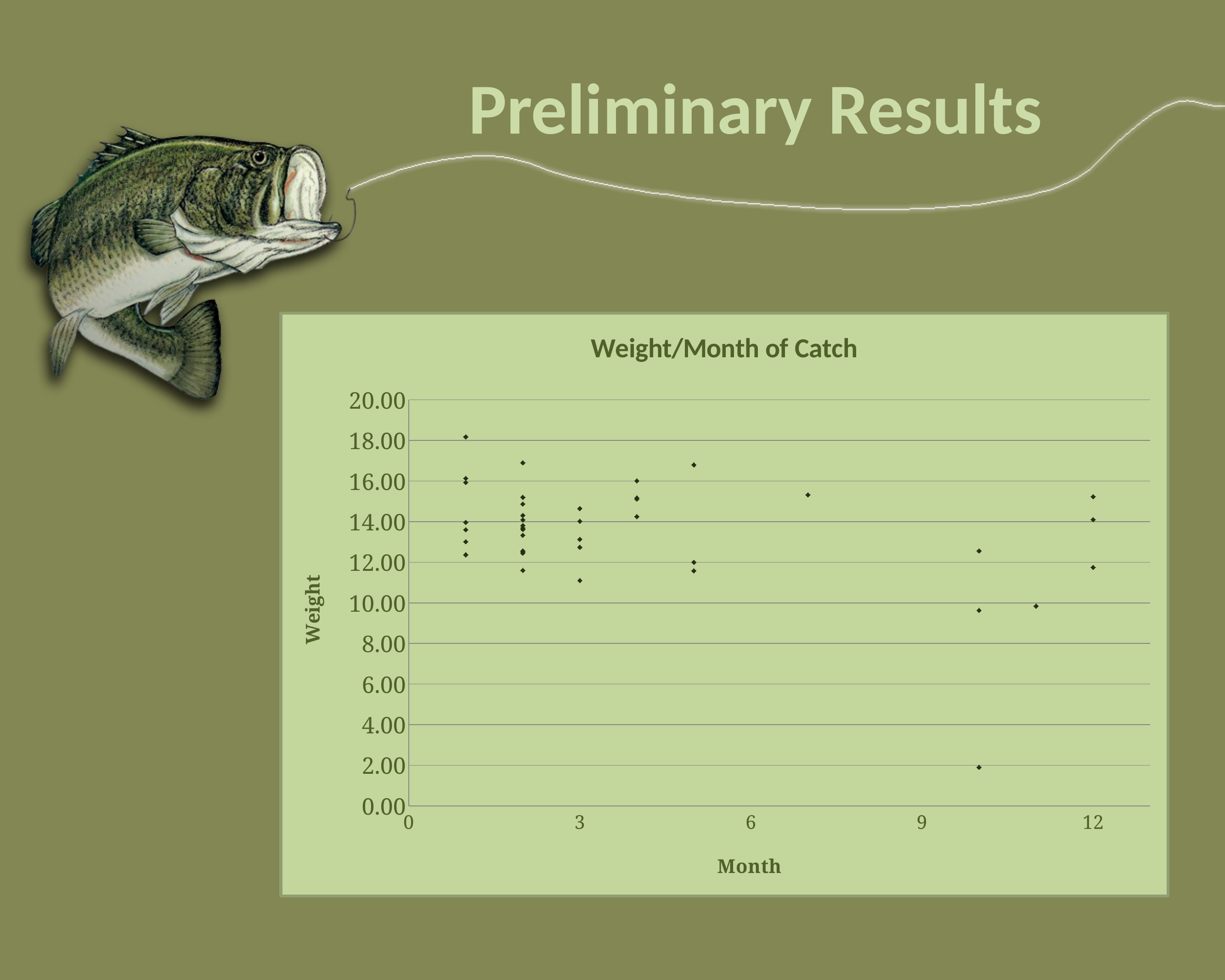
Is the weight of the single point plotted at month 11 greater or less than 12.00? less At which month does the lowest weight point on the chart occur? 10 Is the weight of the single point plotted at month 7 greater or less than 14.00? greater What is the label of the vertical axis of the chart? Weight Which is larger: the single point at month 7 or the single point at month 11? month 7 Is the lowest point plotted at month 10 greater or less than 4.00? less What is the maximum value shown on the vertical axis of the chart? 20.00 At which month does the highest weight point on the chart occur? 1 Which month has more plotted points: month 2 or month 12? month 2 What kind of chart is shown on the slide? scatter chart What is the title of the chart? Weight/Month of Catch